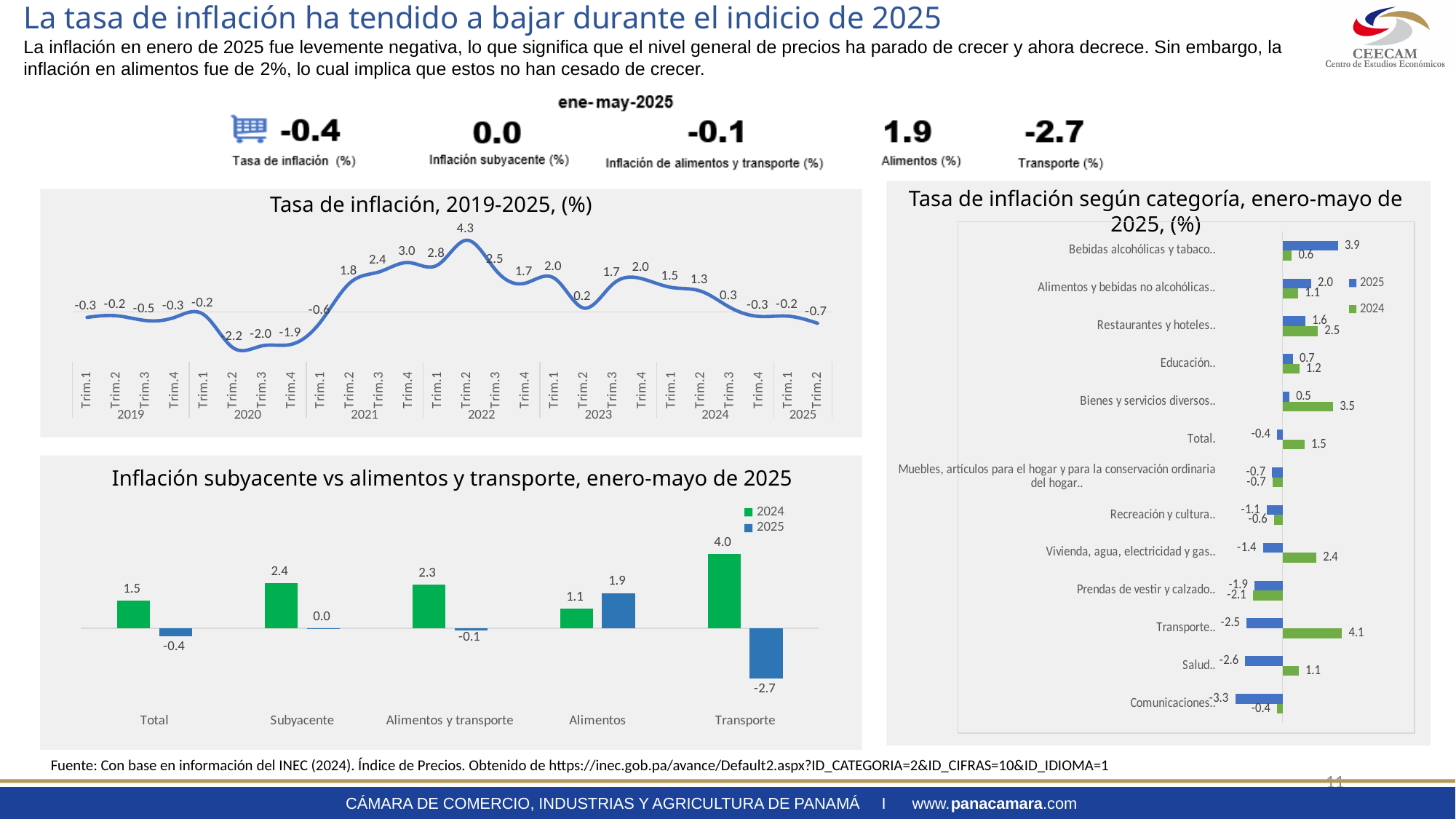
In the chart 'Tasa de inflación según categoría, enero-mayo de 2025, (%)', what is the 2025 value for Comunicaciones? -3.3 In the chart 'Tasa de inflación, 2019-2025, (%)', what is the value for Trim.2 of 2022? 4.3 How many categories are shown in the chart 'Tasa de inflación según categoría, enero-mayo de 2025, (%)'? 13 In the chart 'Tasa de inflación según categoría, enero-mayo de 2025, (%)', is the 2025 value for Bebidas alcohólicas y tabaco larger or the 2024 value? 2025 In the chart 'Inflación subyacente vs alimentos y transporte, enero-mayo de 2025', what is the 2025 value for Transporte? -2.7 In the chart 'Tasa de inflación, 2019-2025, (%)', which quarter has the lowest value? Trim.2 2020 What kind of chart is 'Tasa de inflación, 2019-2025, (%)'? line chart In the chart 'Tasa de inflación según categoría, enero-mayo de 2025, (%)', which category has the highest 2024 value? Transporte How many series does the legend list in the chart 'Inflación subyacente vs alimentos y transporte, enero-mayo de 2025'? 2 In the chart 'Tasa de inflación, 2019-2025, (%)', what is the value for Trim.2 of 2025? -0.7 In the chart 'Inflación subyacente vs alimentos y transporte, enero-mayo de 2025', what is the difference between the 2024 and 2025 values for Alimentos? 0.8 In the chart 'Inflación subyacente vs alimentos y transporte, enero-mayo de 2025', which category has the highest 2024 value? Transporte